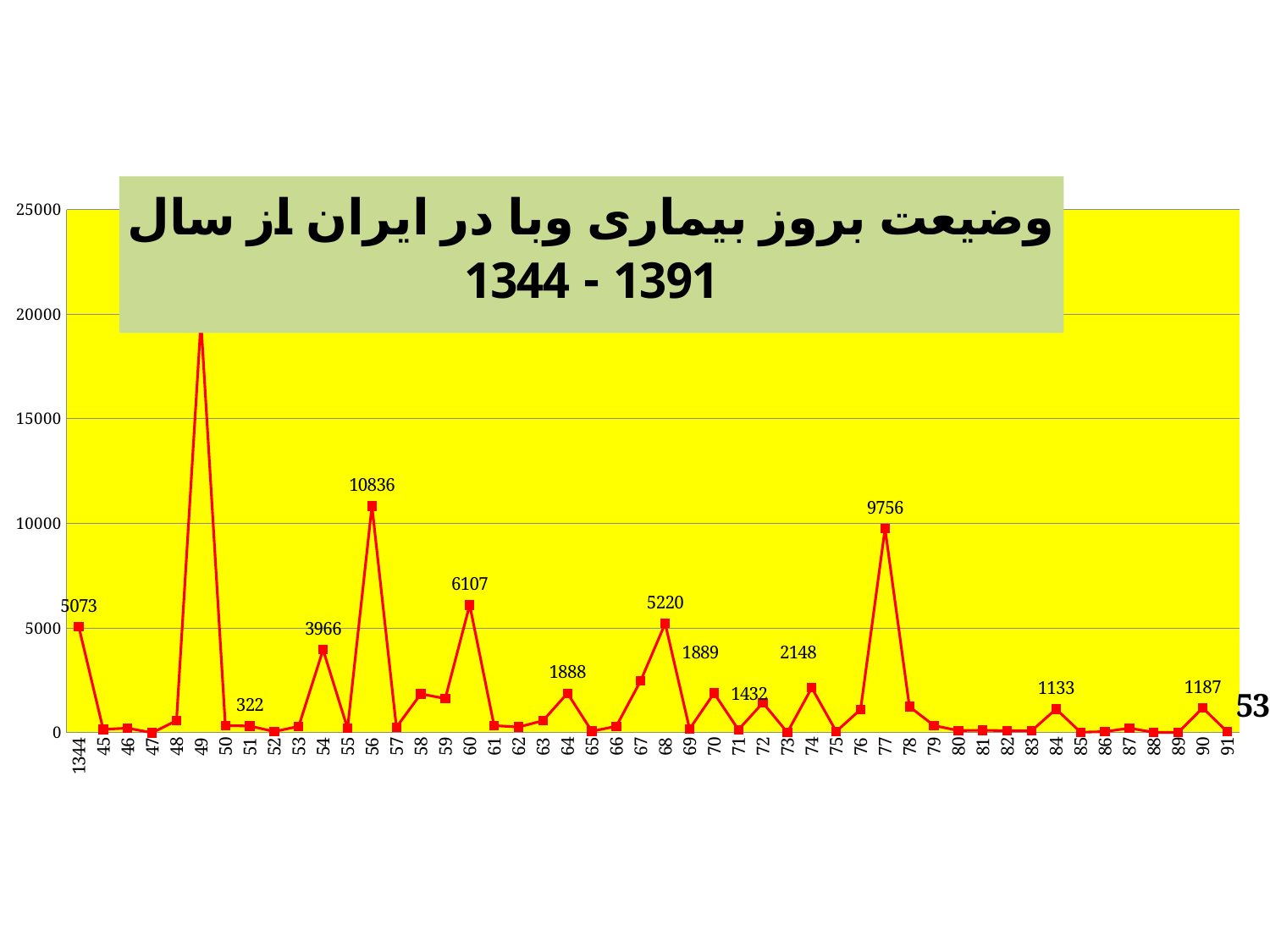
What is the value for year 51? 322 What is the difference between the values for year 56 and year 77? 1080 What is the value for year 84? 1133 What kind of chart is shown on the slide? line chart How many data points are plotted on the chart? 48 Is the value for year 49 greater or less than 15000? greater Which year has the highest value on the chart? 49 Is the value for year 58 greater or less than 5000? less What is the value for year 56? 10836 What is the value for year 77? 9756 What is the value for year 1344? 5073 Which is larger, the value for year 60 or the value for year 68? 60